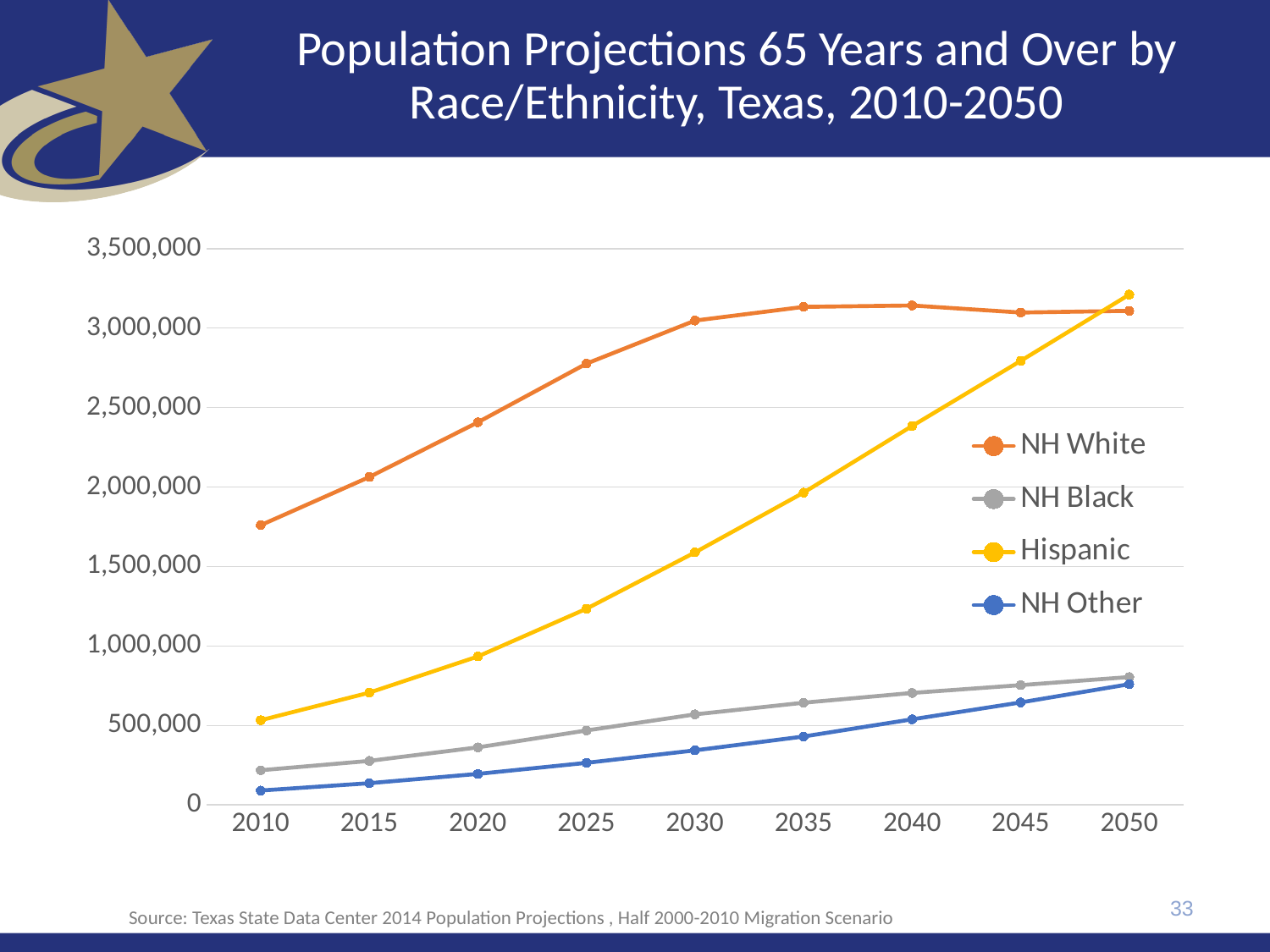
Is the value for NH White in 2010 greater or less than 1,500,000? greater In 2010, which is larger: NH White or Hispanic? NH White Does the Hispanic series rise or fall from 2010 to 2050? Rise What kind of chart is shown on the slide? Line chart What is the title of the chart? Population Projections 65 Years and Over by Race/Ethnicity, Texas, 2010-2050 Which series has the highest value in 2040? NH White Is the value for NH Black in 2050 greater or less than 1,000,000? less Is the value for Hispanic in 2050 greater or less than 3,000,000? greater How many years are plotted along the x axis? 9 Which series has the lowest value in 2010? NH Other How many series does the legend list? 4